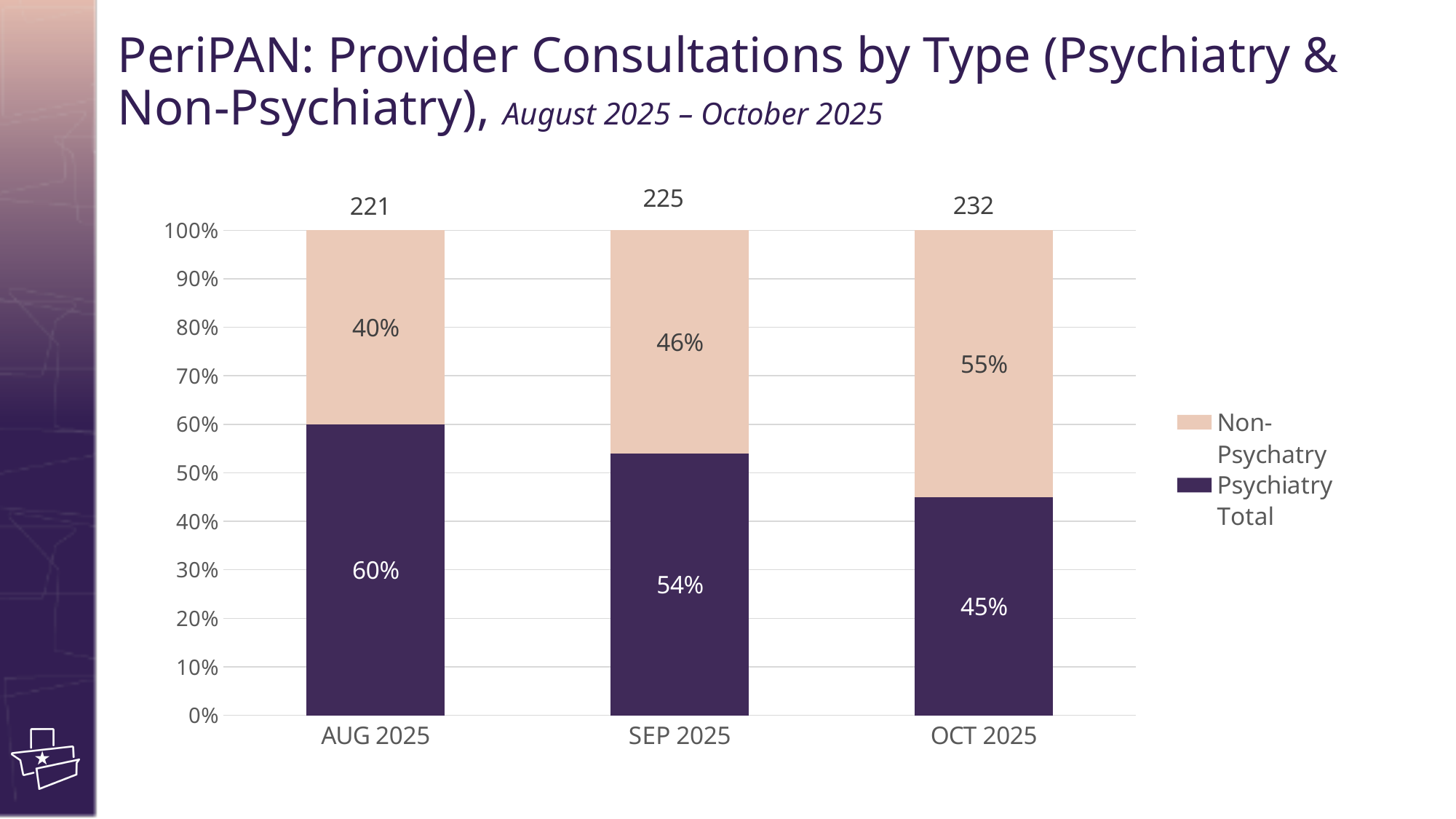
What percentage of consultations in OCT 2025 were Non-Psychatry? 55% Which is larger in SEP 2025: the Psychiatry Total share or the Non-Psychatry share? Psychiatry Total Which month has the highest Psychiatry Total share? AUG 2025 Which month has the highest total number of consultations? OCT 2025 How many months are shown on the x axis? 3 What percentage of consultations in AUG 2025 were Psychiatry Total? 60% Does the Psychiatry Total share rise or fall from AUG 2025 to OCT 2025? Fall What kind of chart is shown on the slide? Stacked bar chart How many series does the legend list? 2 What is the difference between the Psychiatry Total share in AUG 2025 and OCT 2025? 15% Which month has the lowest Non-Psychatry share? AUG 2025 What is the total number of consultations shown above the SEP 2025 bar? 225